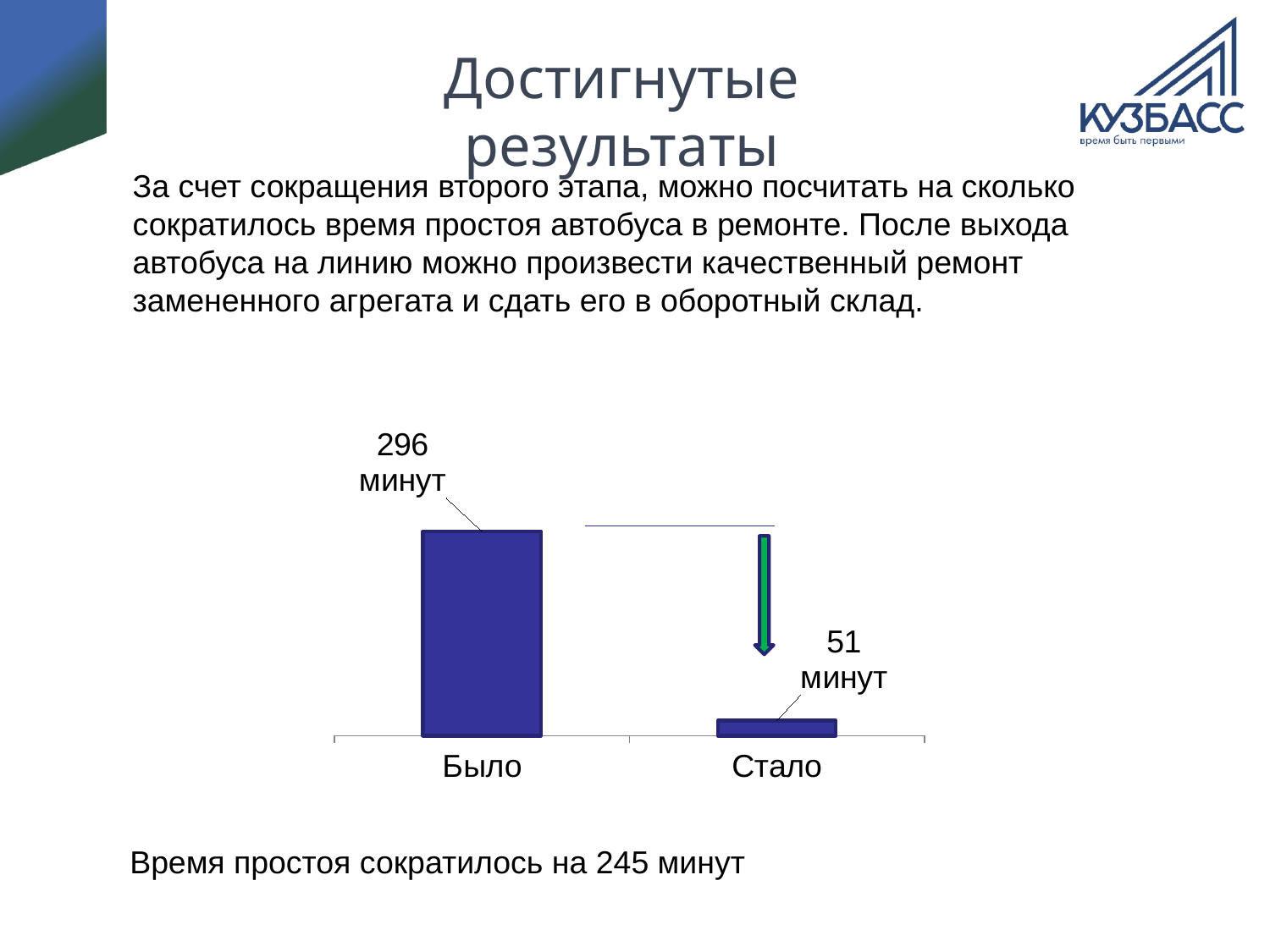
How many categories are shown on the chart? 2 Which category has the highest value? Было What are the two category labels on the x axis? Было, Стало Which is larger, the value for Было or the value for Стало? Было What is the value for Было? 296 минут Which category has the lowest value? Стало What is the difference between the values for Было and Стало? 245 минут What colour are the bars in the chart? blue What is the value for Стало? 51 минут What kind of chart is shown on the slide? bar chart Do the values rise or fall from Было to Стало? fall